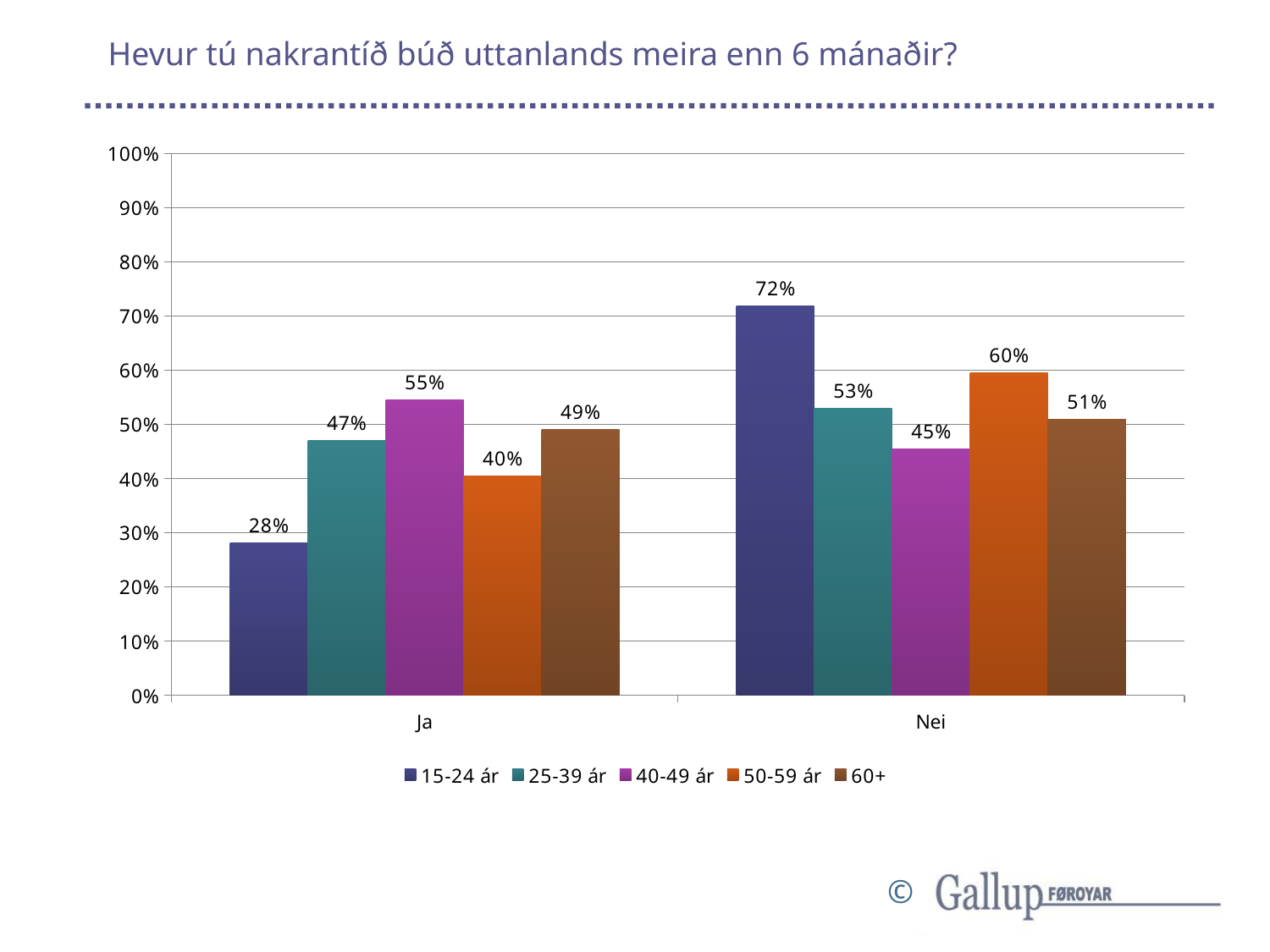
Which is larger: the 25-39 ár value for Ja or the 25-39 ár value for Nei? Nei What is the value for the 15-24 ár series in the Ja category? 28% Which age group has the highest value in the Nei category? 15-24 ár How many categories are shown on the x axis? 2 What is the title of the chart? Hevur tú nakrantíð búð uttanlands meira enn 6 mánaðir? How many series does the legend list? 5 What is the value for the 40-49 ár series in the Ja category? 55% What is the difference between the 15-24 ár values for Nei and Ja? 44% What is the value for the 50-59 ár series in the Nei category? 60% What kind of chart is shown on the slide? bar chart Is the value for 60+ in the Ja category greater or less than 40%? greater Which age group has the lowest value in the Ja category? 15-24 ár